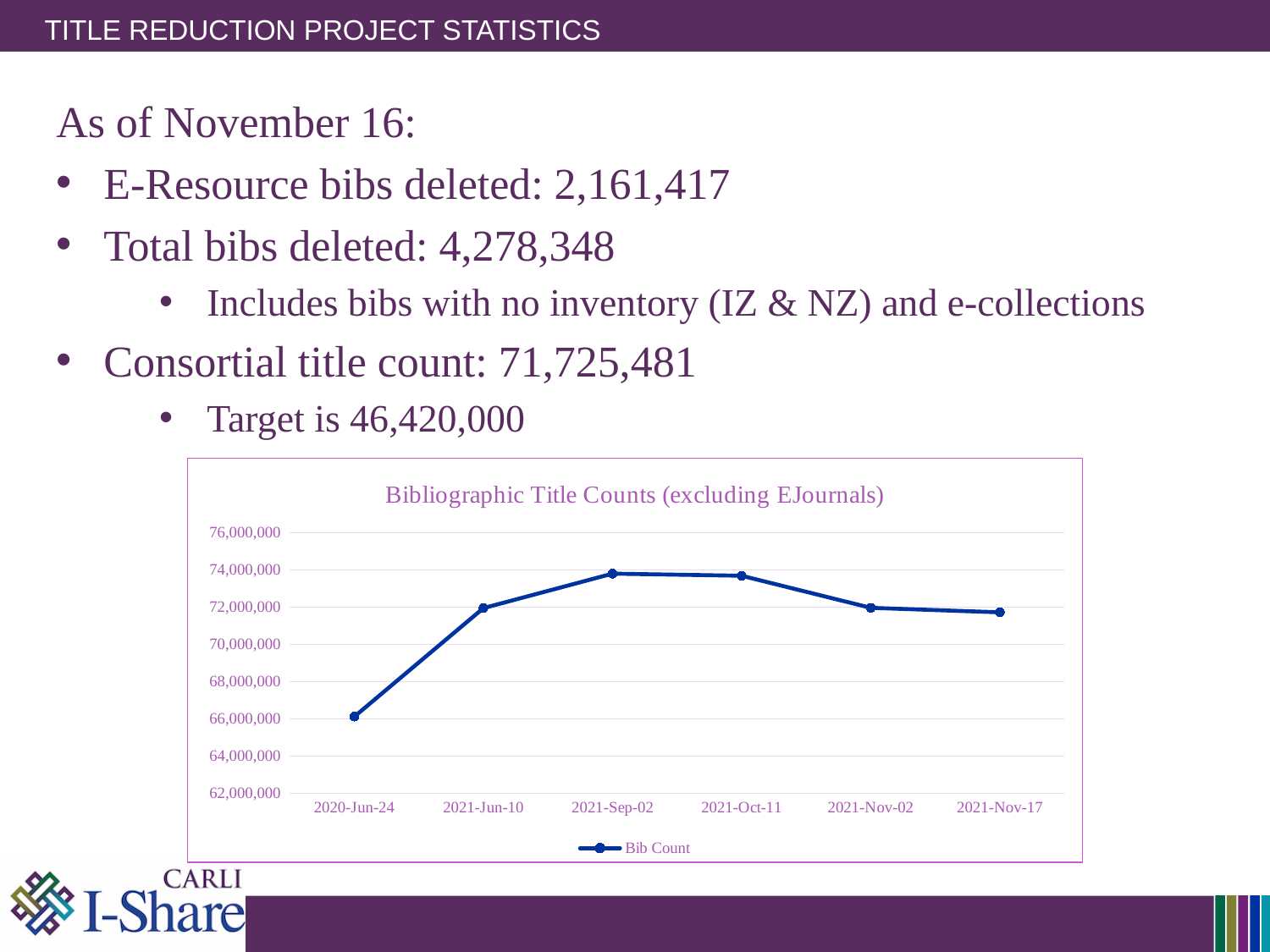
Does the Bib Count rise or fall from 2021-Sep-02 to 2021-Nov-17? fall What kind of chart is shown on the slide? line chart What is the name of the series shown in the legend? Bib Count Which date has the lowest Bib Count? 2020-Jun-24 How many data points are plotted on the chart? 6 Is the Bib Count for 2020-Jun-24 greater or less than 68,000,000? less Is the Bib Count for 2021-Sep-02 greater or less than 72,000,000? greater How many series does the chart's legend list? 1 Is the Bib Count for 2021-Nov-17 greater or less than 70,000,000? greater Which has a larger Bib Count, 2020-Jun-24 or 2021-Jun-10? 2021-Jun-10 What is the title of the chart? Bibliographic Title Counts (excluding EJournals)